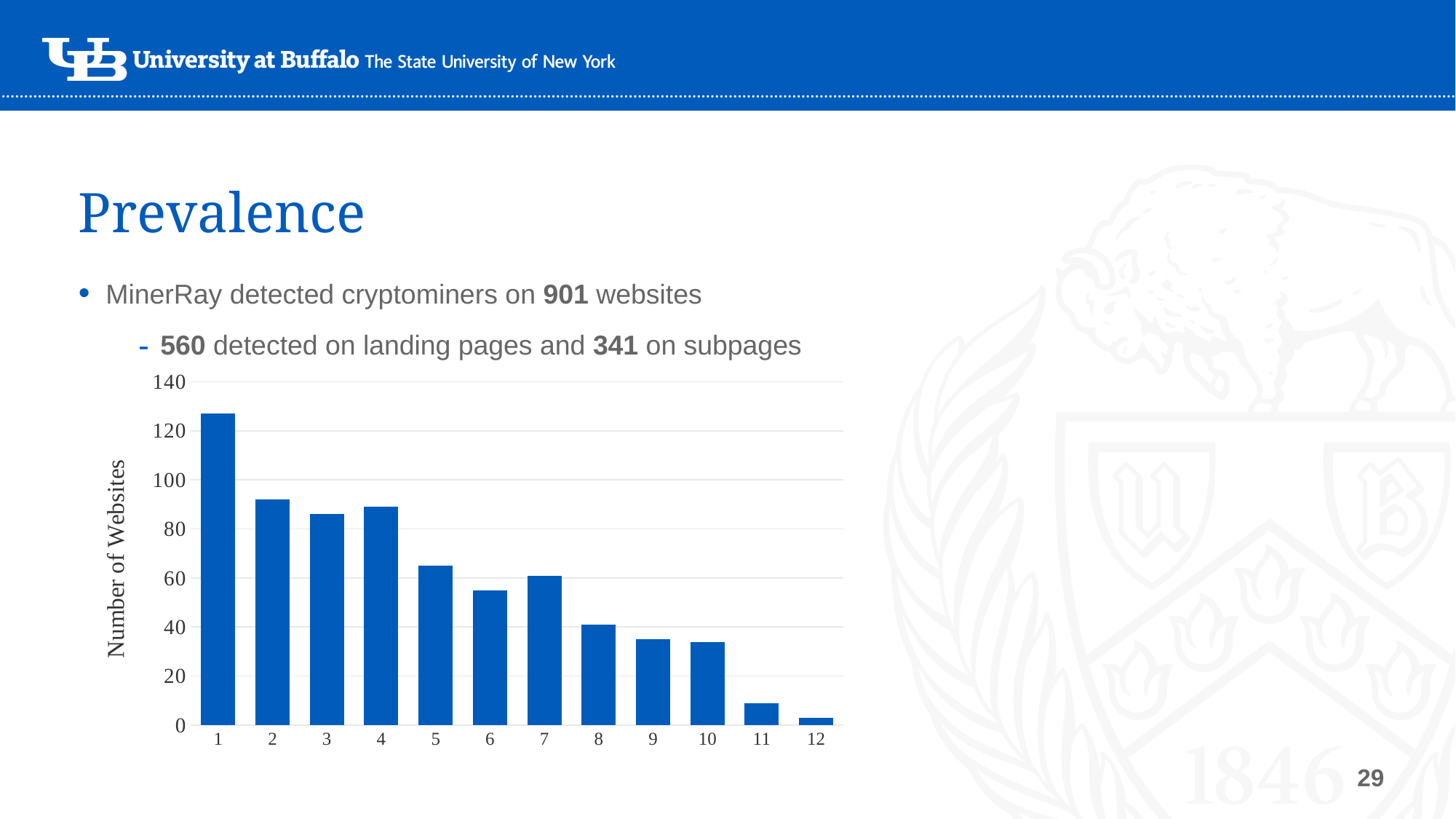
Which category has the lowest number of websites? 12 Do the values generally rise or fall from category 1 to category 12? fall What is the label on the y axis of the chart? Number of Websites What kind of chart is shown on the slide? bar chart Is the value for category 2 greater or less than 100? less Which category has the highest number of websites? 1 Which has a larger value, category 8 or category 5? 5 Is the value for category 11 greater or less than 20? less How many categories are shown on the x axis of the chart? 12 Is the value for category 5 greater or less than 60? greater Which has a larger value, category 1 or category 2? 1